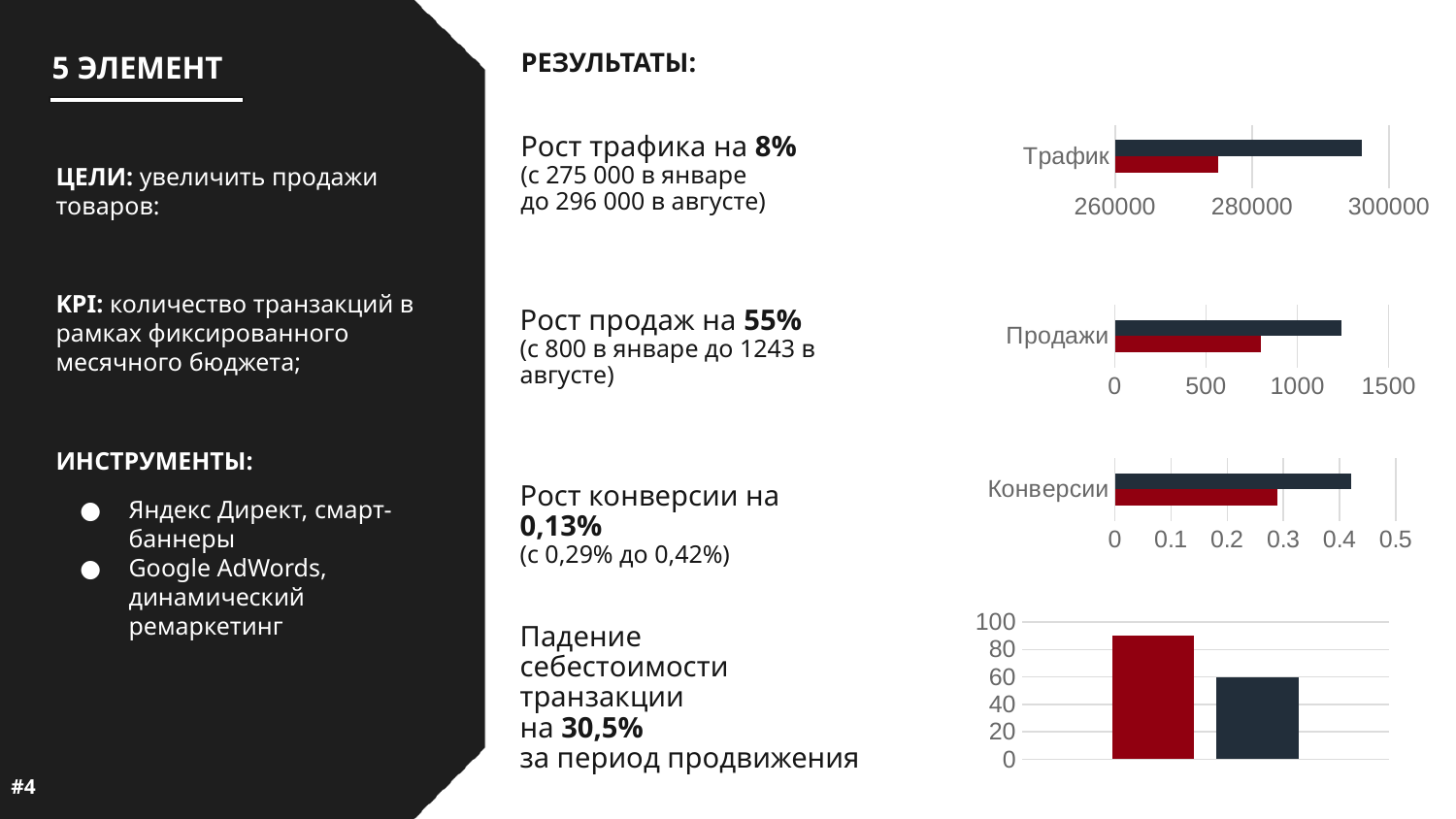
In the Конверсии chart, is the value of the dark navy bar greater or less than 0.4? greater In the Продажи chart, which bar is longer, the dark navy bar or the dark red bar? the dark navy bar In the Продажи chart, is the value of the dark navy bar greater or less than 1000? greater What is the category label shown on the third chart from the top? Конверсии In the bottom chart with the vertical bars, is the value of the dark red bar greater or less than 80? greater What kind of chart is the top chart labelled Трафик? bar chart In the bottom chart with the vertical bars, which bar is taller, the dark red bar or the dark navy bar? the dark red bar How many bars are shown in the Трафик chart? 2